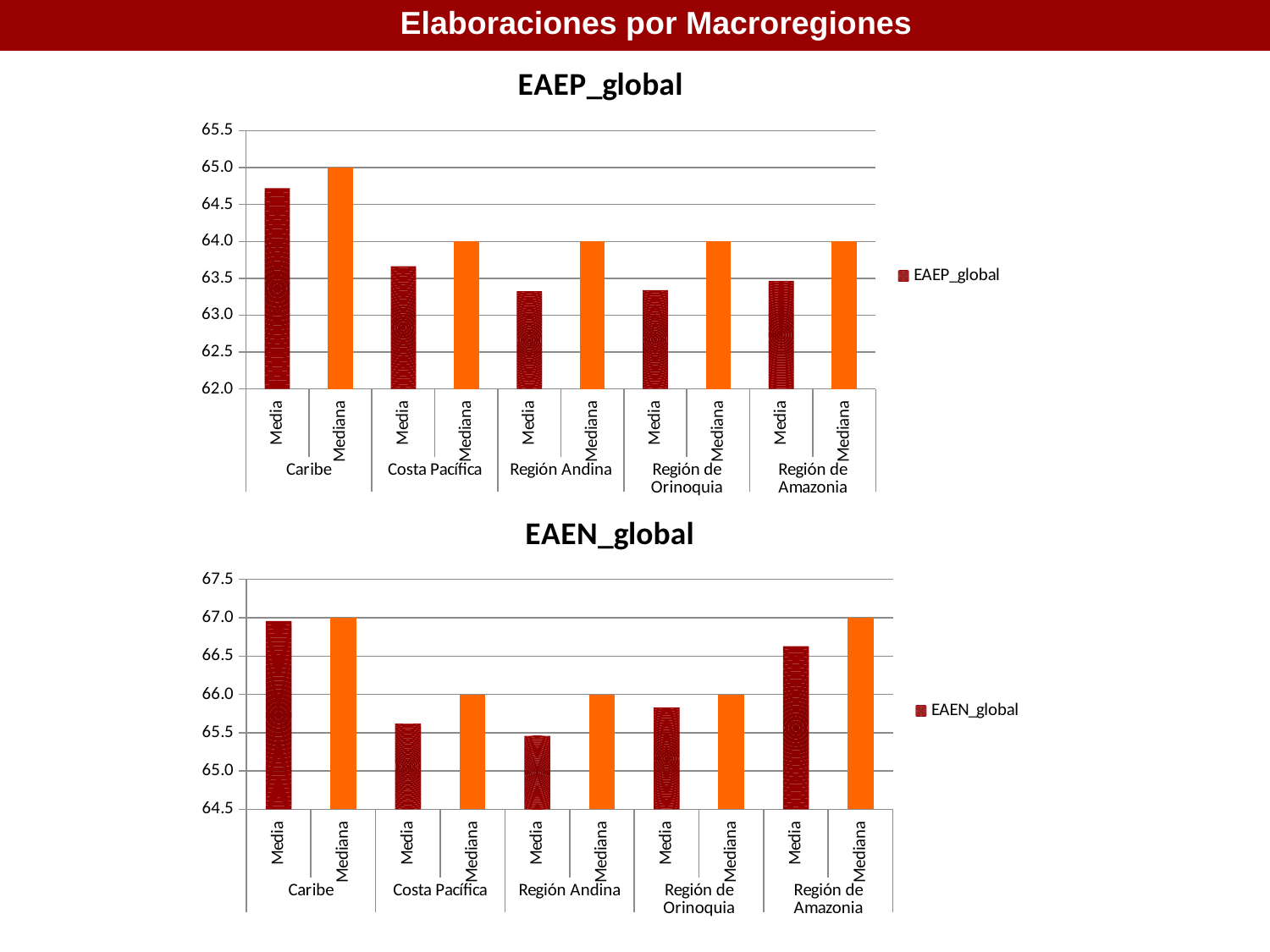
In the EAEP_global chart, is the Media value for Caribe greater or less than 64.5? greater In the EAEN_global chart, which is larger, the Media value for Caribe or the Media value for Costa Pacífica? Caribe In the EAEP_global chart, which region has the highest Media bar? Caribe How many series does the legend of the EAEN_global chart list? 1 In the EAEP_global chart, what is the difference between the Mediana value for Caribe and the Mediana value for Costa Pacífica? 1.0 In the EAEN_global chart, is the Media value for Región de Amazonia greater or less than 66.5? greater How many regions are shown on the x axis of the EAEN_global chart? 5 In the EAEP_global chart, is the Media value for Región Andina greater or less than 63.5? less In the EAEN_global chart, what is the Mediana value for Región de Amazonia? 67.0 What kind of chart is the EAEP_global chart? bar chart In the EAEP_global chart, what is the Mediana value for Región Andina? 64.0 In the EAEP_global chart, what is the Mediana value for Caribe? 65.0